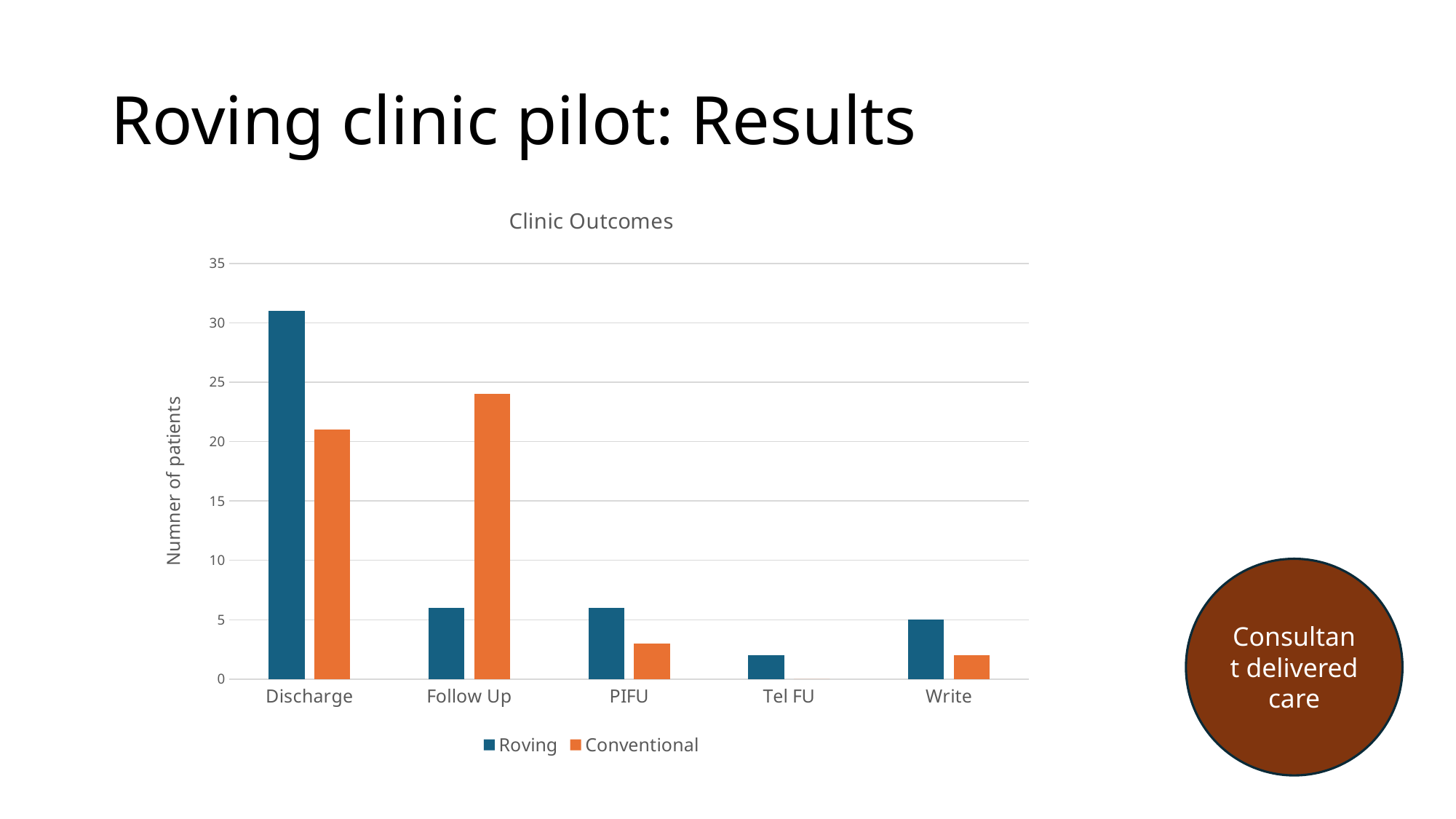
Which category has the lowest Conventional value? Tel FU Which category has the highest Conventional value? Follow Up For Discharge, which series has the larger value, Roving or Conventional? Roving How many outcome categories are shown on the x axis? 5 Is the Conventional value for Follow Up greater or less than 20? greater Which category has the highest Roving value? Discharge How many series does the legend list? 2 Is the Roving value for Follow Up greater or less than 10? less What kind of chart is shown on the slide? bar chart For Follow Up, which series has the larger value, Roving or Conventional? Conventional Is the Roving value for Discharge greater or less than 25? greater What is the title of the chart? Clinic Outcomes